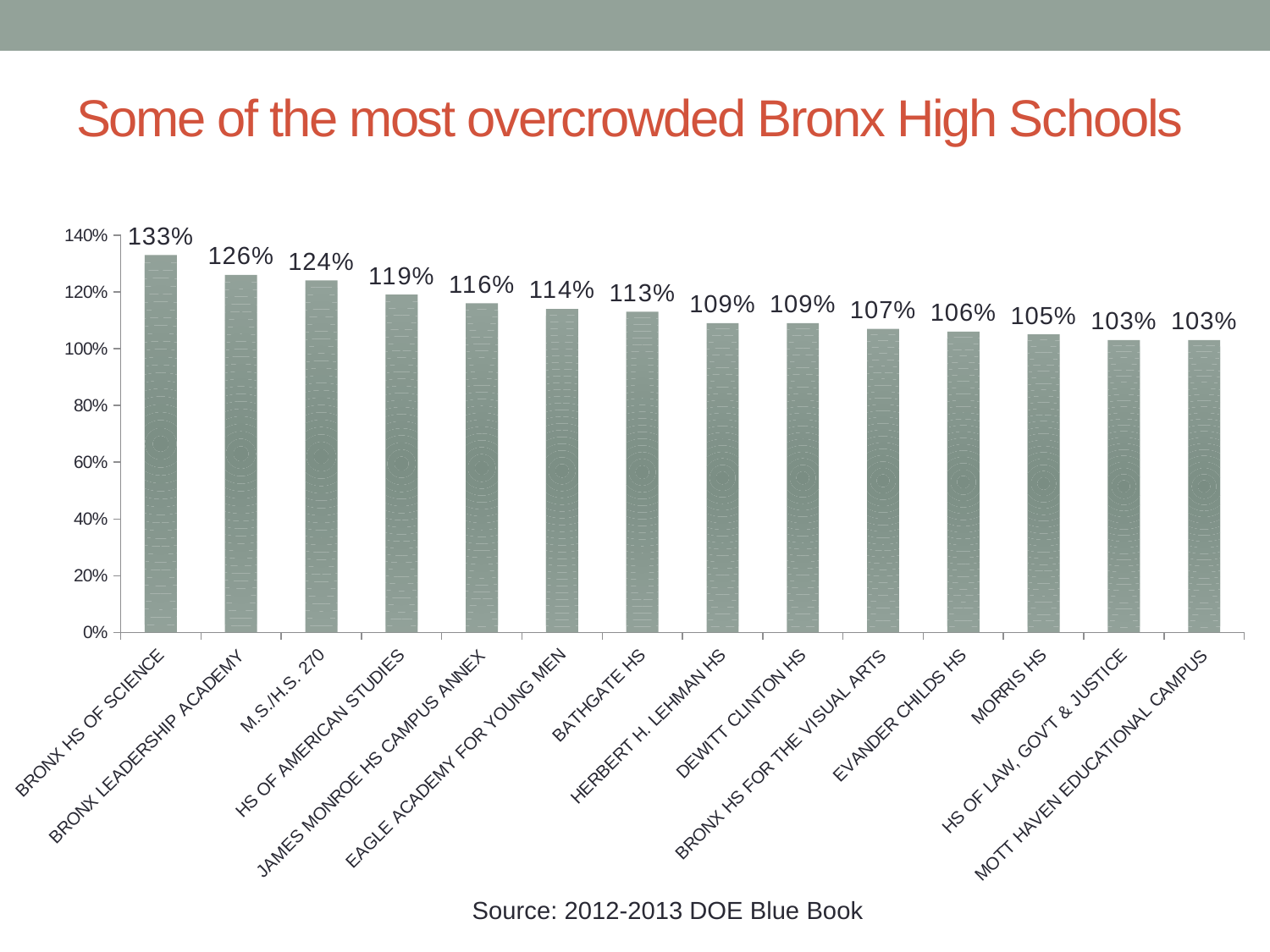
What is the value for EVANDER CHILDS HS? 106% What is the difference between the values for BRONX HS OF SCIENCE and BRONX LEADERSHIP ACADEMY? 7% How many schools are shown in the chart? 14 Which school has the highest value? BRONX HS OF SCIENCE What is the value for BRONX HS OF SCIENCE? 133% What is the value for HS OF AMERICAN STUDIES? 119% Which is larger, the value for BATHGATE HS or the value for DEWITT CLINTON HS? BATHGATE HS What is the title of the slide? Some of the most overcrowded Bronx High Schools Is the value for JAMES MONROE HS CAMPUS ANNEX greater or less than 100%? greater What is the difference between the values for M.S./H.S. 270 and MORRIS HS? 19% What kind of chart is shown on the slide? Bar chart Do the values rise or fall from left to right along the x axis? Fall